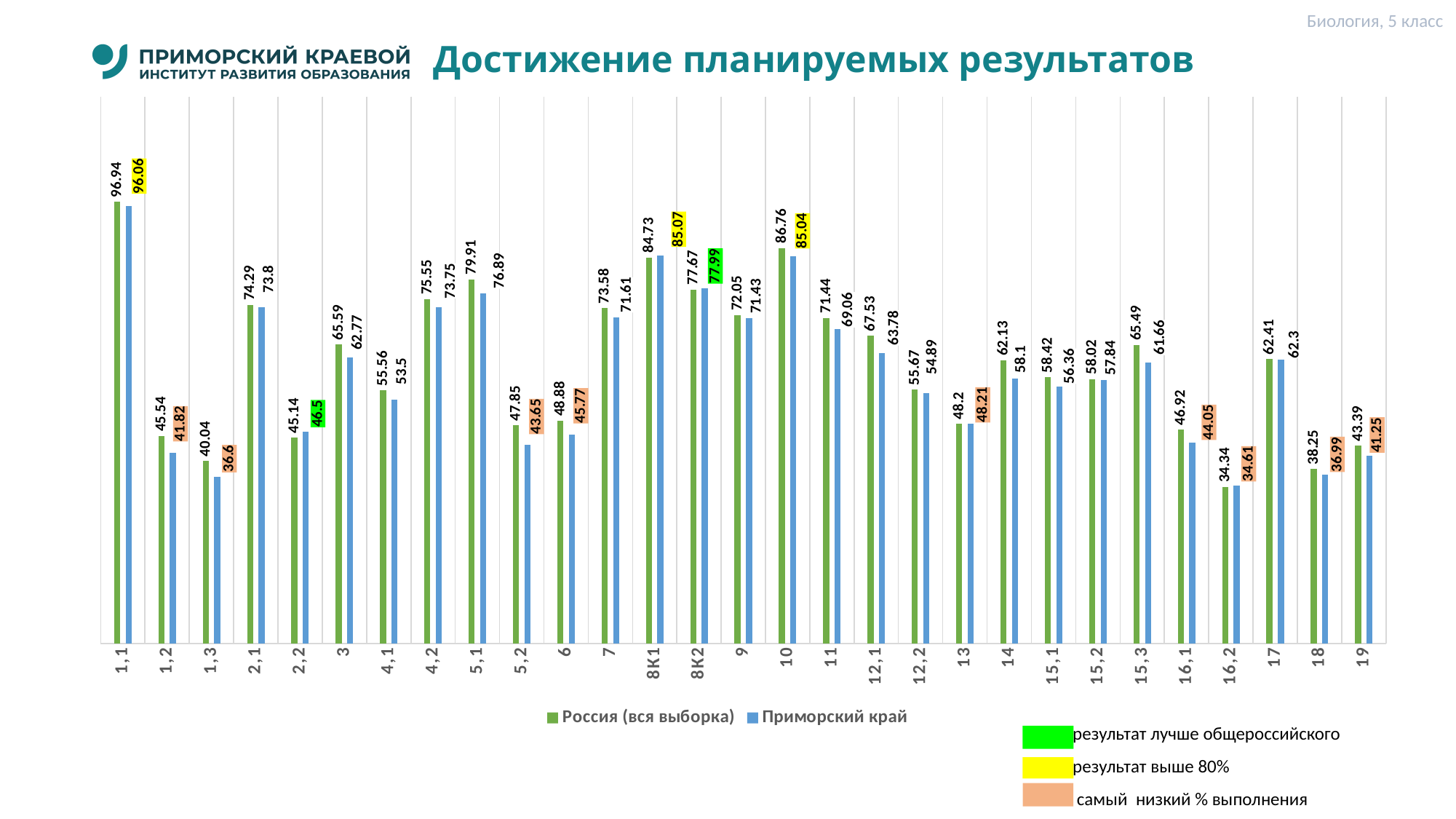
For Россия (вся выборка), which category has the larger value: 5,1 or 4,2? 5,1 What is the value for Приморский край for category 16,2? 34.61 What is the value for Россия (вся выборка) for category 10? 86.76 What is the value for Приморский край for category 1,1? 96.06 What is the difference between Россия (вся выборка) and Приморский край for category 14? 4.03 How many series does the legend list? 2 Which category has the highest value for Приморский край? 1,1 How many categories are shown on the x axis? 29 Which category has the lowest value for Россия (вся выборка)? 16,2 What kind of chart is shown on the slide? bar chart For category 8К1, which series has the larger value: Россия (вся выборка) or Приморский край? Приморский край What is the value for Россия (вся выборка) for category 8К1? 84.73